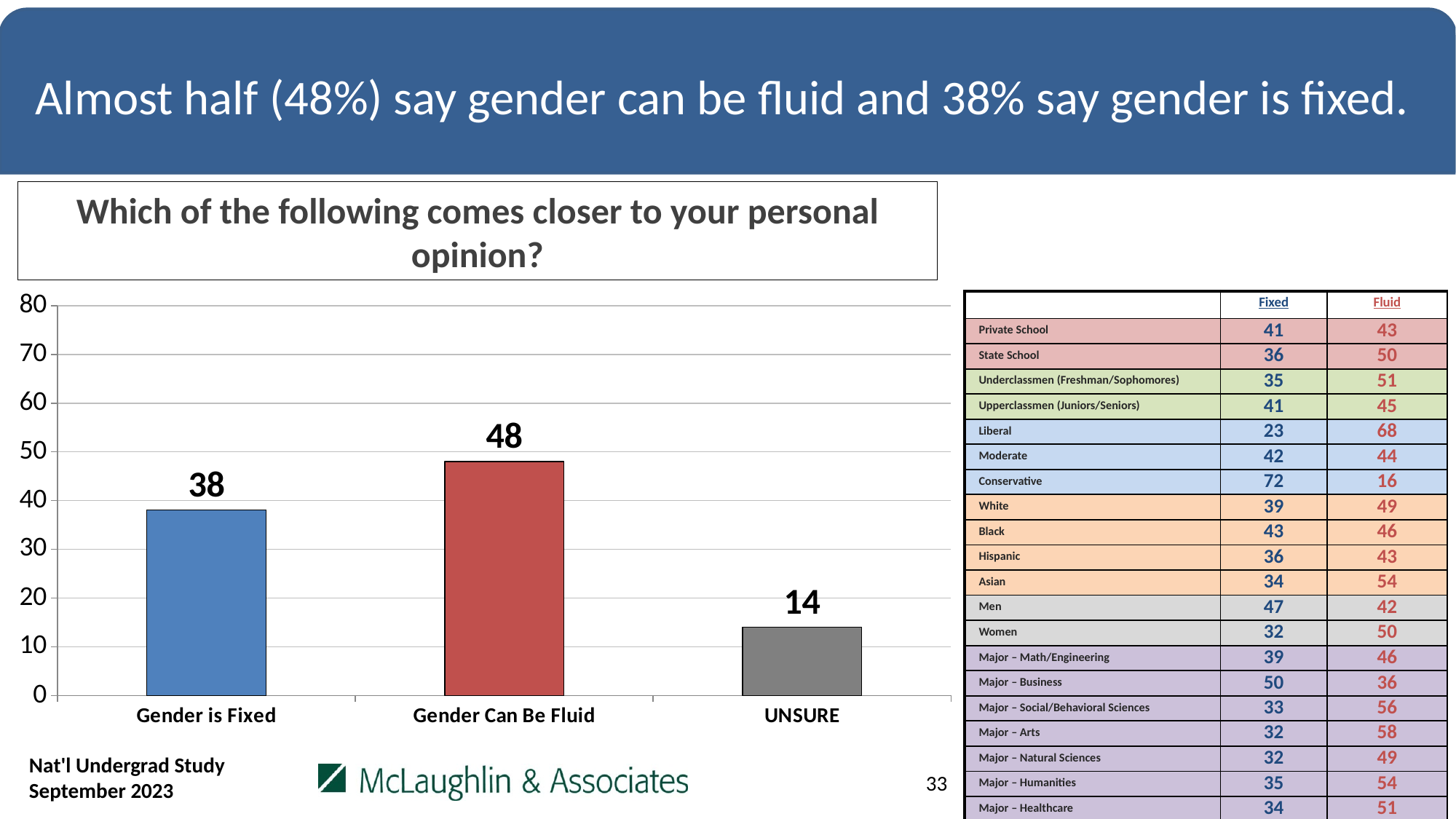
What is the difference between the values for Gender is Fixed and UNSURE? 24 What is the value for Gender Can Be Fluid? 48 Is the value for Gender Can Be Fluid greater or less than 40? greater Which category has the highest value? Gender Can Be Fluid Which category has the lowest value? UNSURE What is the title of the chart? Which of the following comes closer to your personal opinion? What is the value for UNSURE? 14 Which is larger, the value for Gender is Fixed or the value for UNSURE? Gender is Fixed What is the difference between the values for Gender Can Be Fluid and Gender is Fixed? 10 What kind of chart is shown on the slide? bar chart How many categories are shown on the x axis of the chart? 3 What is the value for Gender is Fixed? 38